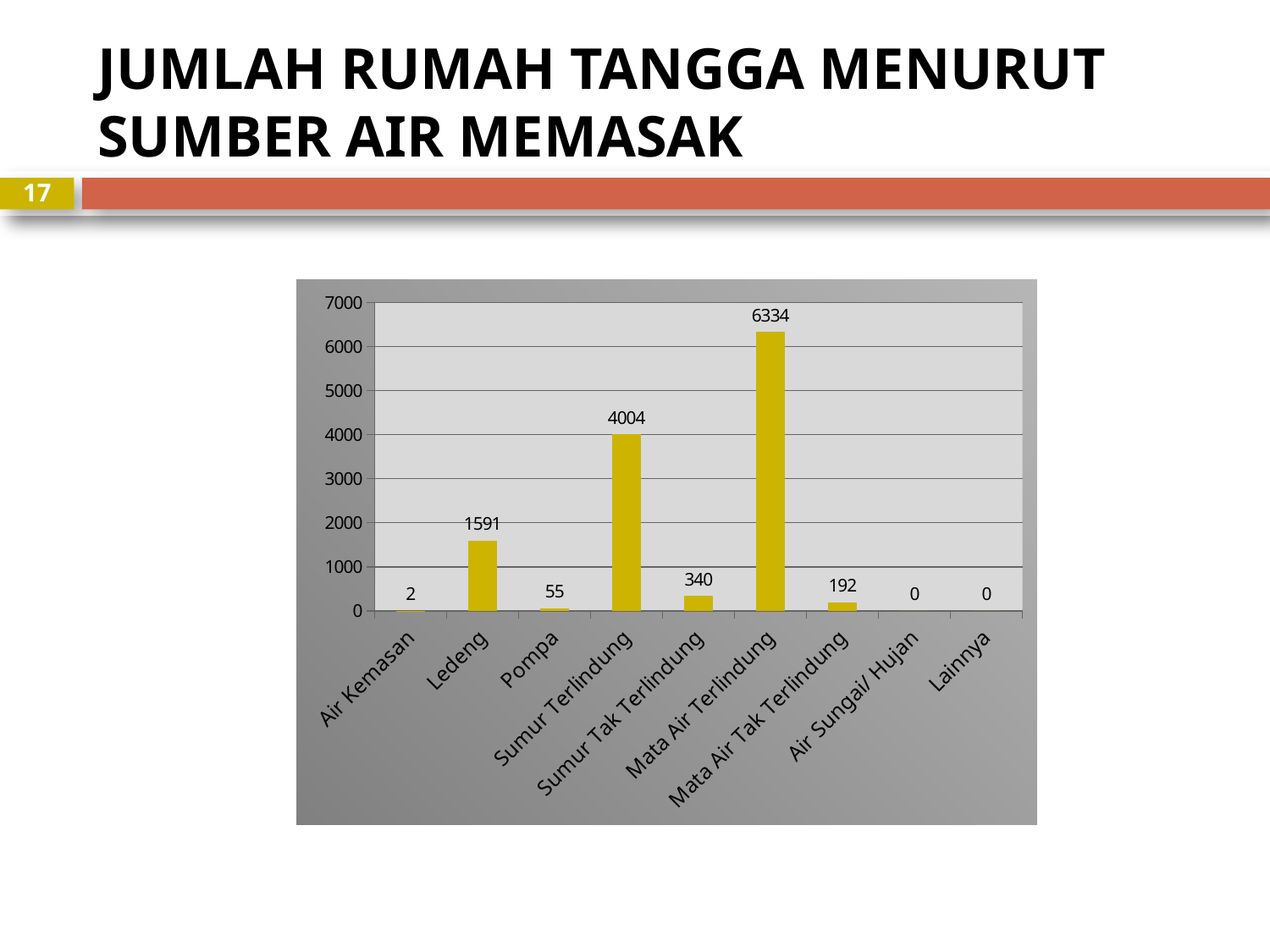
How many categories are shown on the x axis? 9 What is the title of the slide containing the chart? JUMLAH RUMAH TANGGA MENURUT SUMBER AIR MEMASAK What kind of chart is shown on the slide? bar chart What is the value for Mata Air Terlindung? 6334 What is the value for Sumur Tak Terlindung? 340 How many categories have a value of 0? 2 What is the value for Ledeng? 1591 What is the difference between the values for Mata Air Terlindung and Sumur Terlindung? 2330 Which category has the highest value? Mata Air Terlindung Which is larger, the value for Ledeng or the value for Mata Air Tak Terlindung? Ledeng Is the value for Sumur Terlindung greater or less than 3000? greater What is the value for Sumur Terlindung? 4004